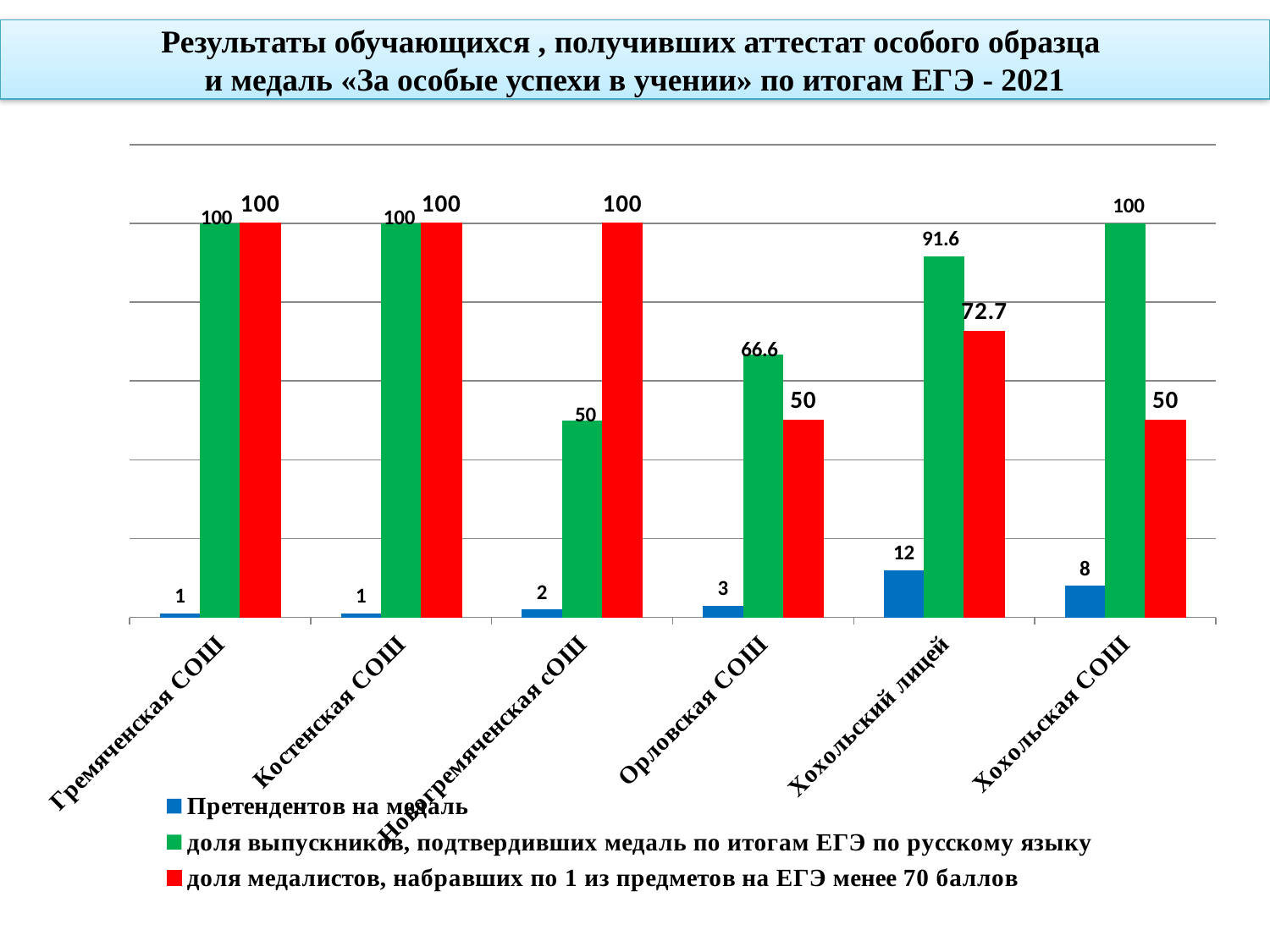
What type of chart is shown on the slide? bar chart How many series does the legend list? 3 What is the value of 'доля выпускников, подтвердивших медаль по итогам ЕГЭ по русскому языку' for Орловская СОШ? 66.6 How many schools (categories) are shown on the x axis? 6 What colour represents the series 'Претендентов на медаль' in the legend? blue What is the difference between 'Претендентов на медаль' for Хохольский лицей and for Хохольская СОШ? 4 Which school has the lowest value for 'доля выпускников, подтвердивших медаль по итогам ЕГЭ по русскому языку'? Новогремяченская сОШ What is the value of 'доля выпускников, подтвердивших медаль по итогам ЕГЭ по русскому языку' for Новогремяченская сОШ? 50 What is the value of 'Претендентов на медаль' for Хохольский лицей? 12 For Орловская СОШ, which is larger: the green series (подтвердивших медаль по русскому языку) or the red series (менее 70 баллов)? the green series (66.6) Which school has the highest value for 'Претендентов на медаль'? Хохольский лицей What is the value of 'доля медалистов, набравших по 1 из предметов на ЕГЭ менее 70 баллов' for Хохольский лицей? 72.7